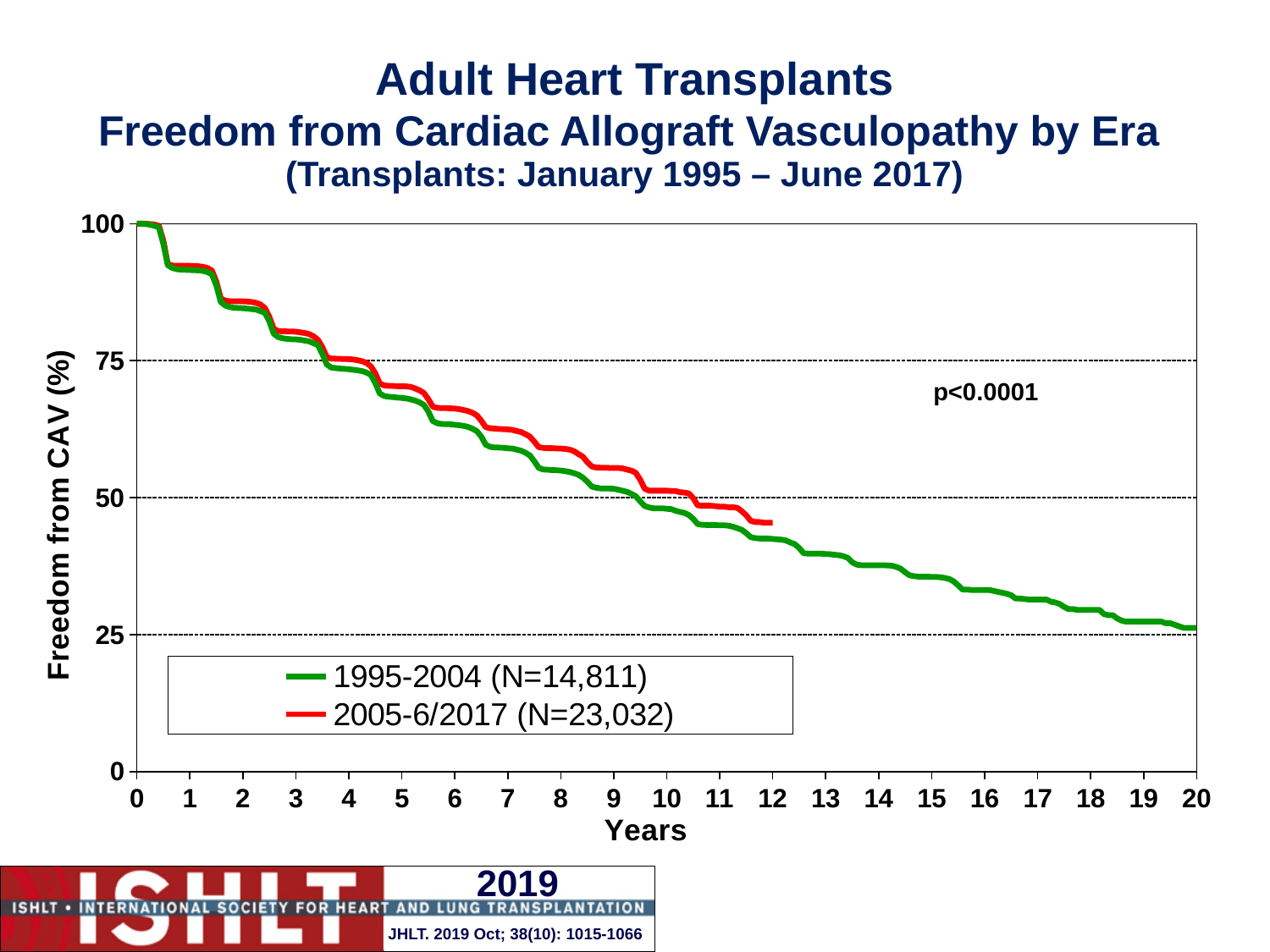
Is the value for the 2005-6/2017 series at 5 years greater or less than 75? less What is the N shown in the legend for the 2005-6/2017 series? N=23,032 Is the value for the 1995-2004 series at 2 years greater or less than 75? greater Is the value for the 2005-6/2017 series at 12 years greater or less than 50? less What kind of chart is shown on the slide? Line chart Does freedom from CAV rise or fall as years since transplant increase? Fall How many series does the legend list? 2 What p-value is printed on the chart? p<0.0001 At 8 years, which series has the higher freedom from CAV, 1995-2004 or 2005-6/2017? 2005-6/2017 Which series extends further along the x axis, 1995-2004 or 2005-6/2017? 1995-2004